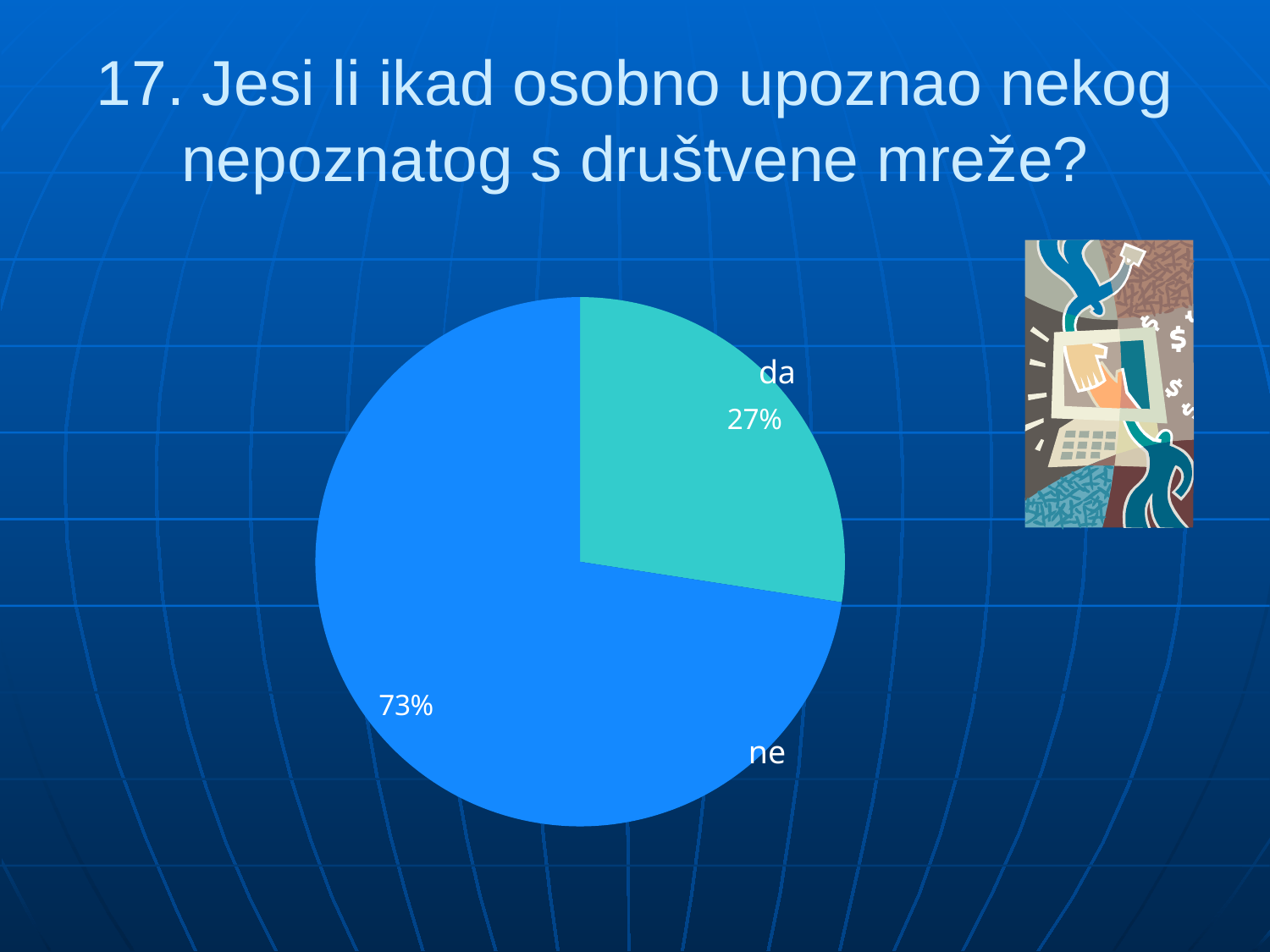
Which slice of the pie chart is the largest? ne What kind of chart is shown on the slide? pie chart What is the total of the two slice percentages shown on the pie chart? 100% Which slice is larger, "da" or "ne"? ne What colour is the "ne" slice of the pie chart? blue What percentage of the pie chart is labelled "da"? 27% What percentage of the pie chart is labelled "ne"? 73% What share of the pie does the "da" slice represent? 27% Which slice of the pie chart is the smallest? da What is the title of the slide containing the pie chart? 17. Jesi li ikad osobno upoznao nekog nepoznatog s društvene mreže? How many slices does the pie chart have? 2 What is the difference in percentage points between the "ne" slice and the "da" slice? 46